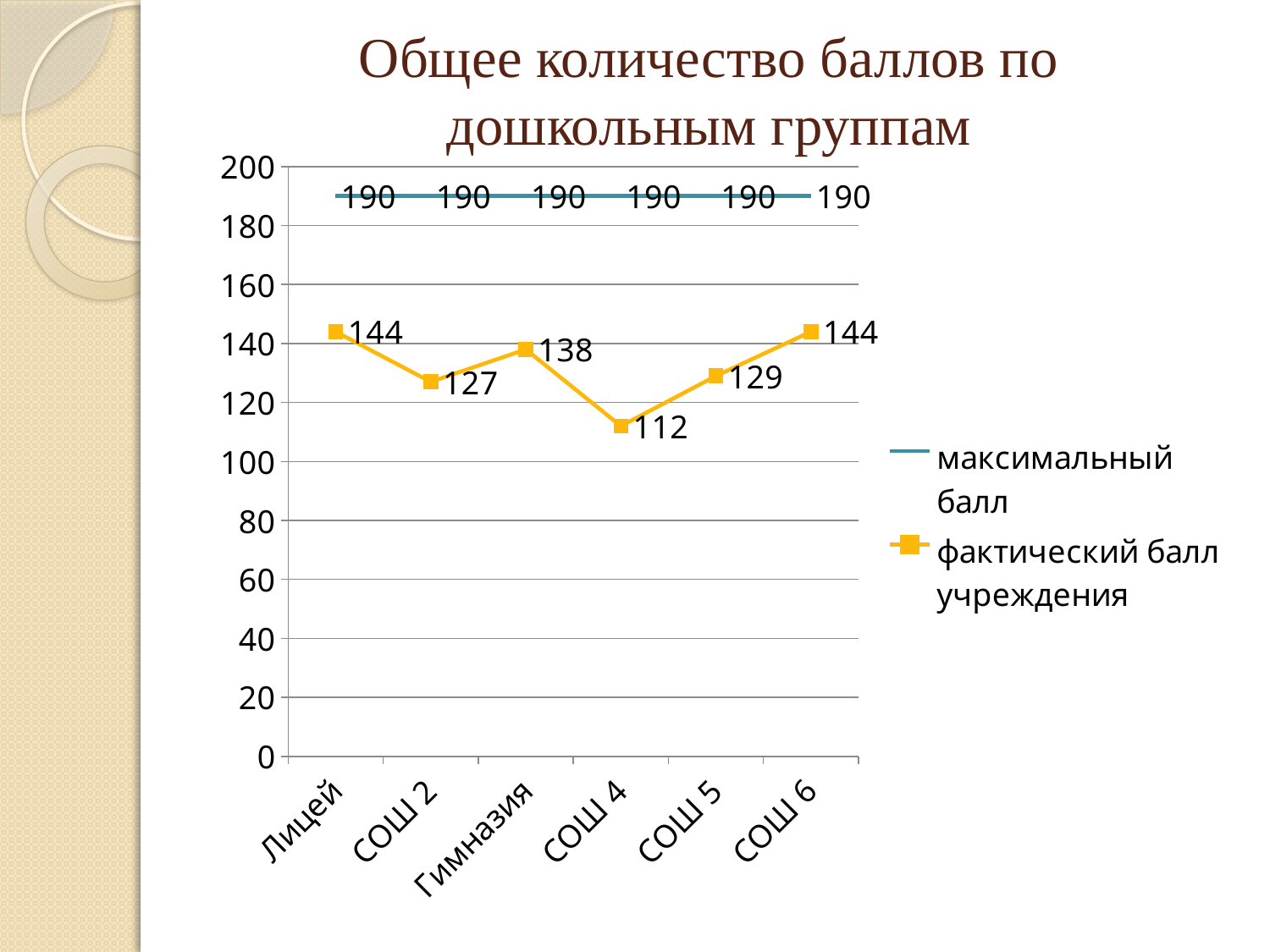
What is the title of the chart? Общее количество баллов по дошкольным группам What kind of chart is shown on the slide? line chart How many series does the legend list? 2 What is the difference between the фактический балл учреждения for Лицей and for СОШ 2? 17 Which category has the lowest фактический балл учреждения? СОШ 4 Which has a higher фактический балл учреждения, Гимназия or СОШ 5? Гимназия What is the максимальный балл for СОШ 2? 190 How many categories are shown on the x axis? 6 What is the difference between the максимальный балл and the фактический балл учреждения for СОШ 5? 61 What is the фактический балл учреждения for СОШ 4? 112 What is the фактический балл учреждения for Гимназия? 138 Is the фактический балл учреждения for СОШ 2 greater or less than 120? greater